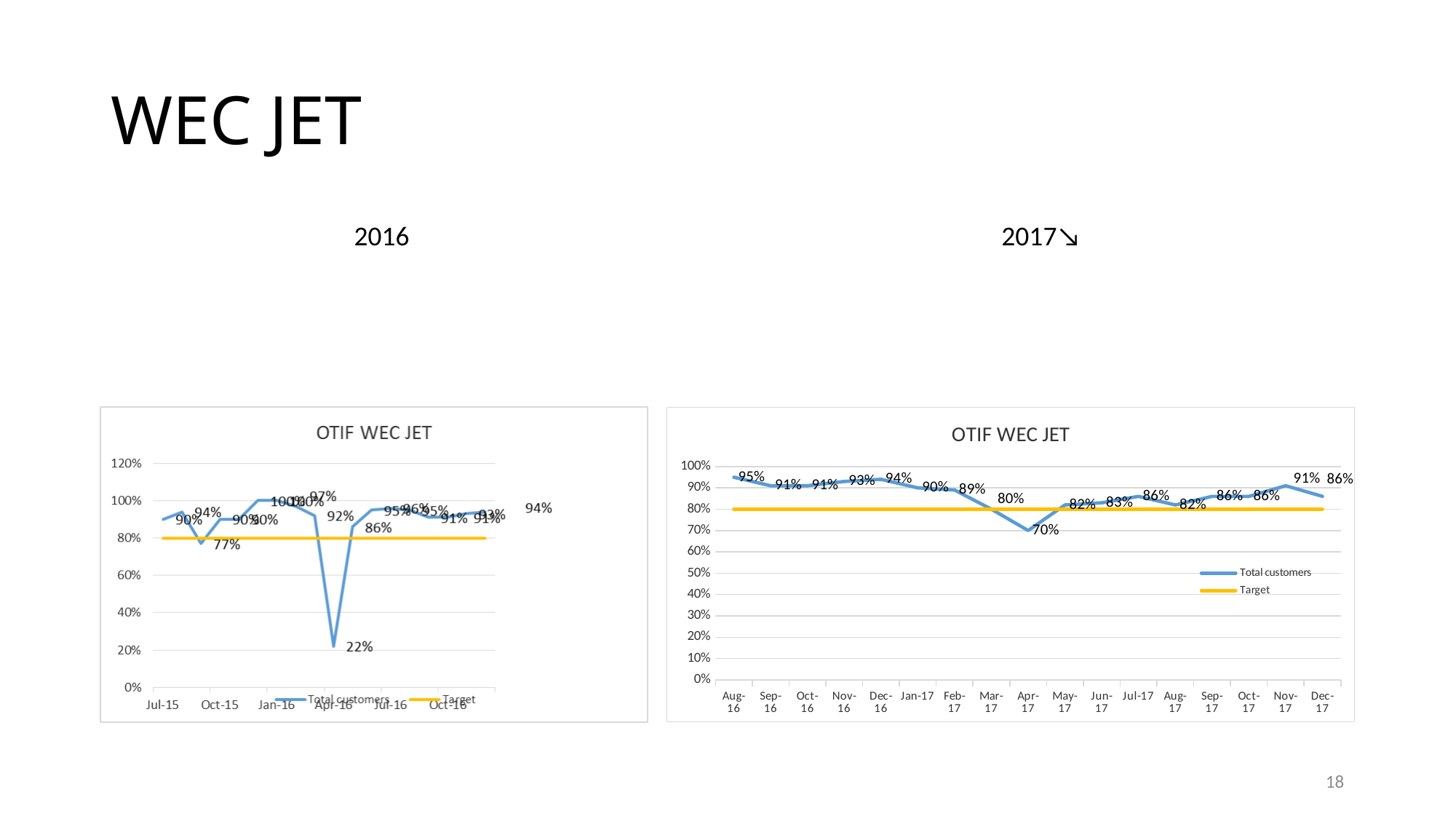
How many months are plotted on the x axis of the right-hand chart (2017)? 17 In the right-hand chart (2017), what is the Total customers value for Apr-17? 70% In the right-hand chart (2017), which month has the lowest Total customers value? Apr-17 In the left-hand chart (2016), what is the lowest Total customers value shown? 22% In the right-hand chart (2017), which is larger, the value for Nov-17 or the value for Dec-17? Nov-17 In the right-hand chart (2017), which month has the highest Total customers value? Aug-16 In the right-hand chart (2017), what is the Total customers value for Aug-16? 95% In the right-hand chart (2017), is the value for Apr-17 greater or less than 80%? less In the right-hand chart (2017), what is the difference between the Aug-16 value and the Apr-17 value? 25 percentage points In the right-hand chart (2017), what is the Total customers value for Nov-17? 91% How many series does the legend of the right-hand chart (2017) list? 2 What kind of chart is the left-hand chart (2016)? Line chart